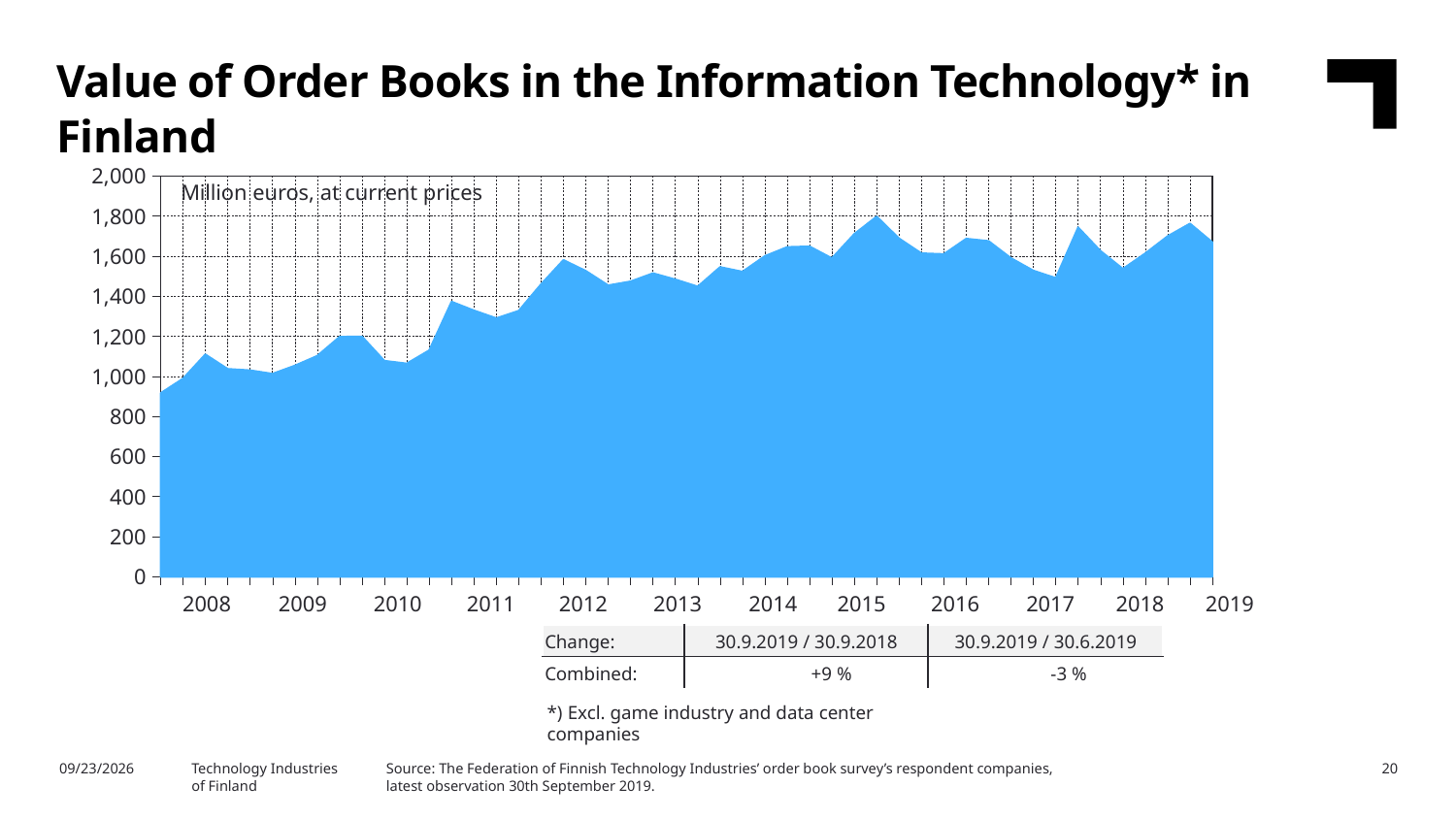
What is the title of the chart? Value of Order Books in the Information Technology* in Finland What kind of chart is shown on the slide? Area chart Is the value at the beginning of 2012 greater or less than 1,400? greater In what unit are the values on the chart expressed? Million euros, at current prices Is the value at the start of 2008 greater or less than 1,000? less In which year does the series reach its lowest value? 2008 What is the highest value shown on the vertical axis? 2,000 Is the value at the end of the series in 2019 greater or less than 1,600? greater Overall, do the values rise or fall from 2008 to 2019? rise Is the value in 2015 larger or smaller than the value in 2008? larger